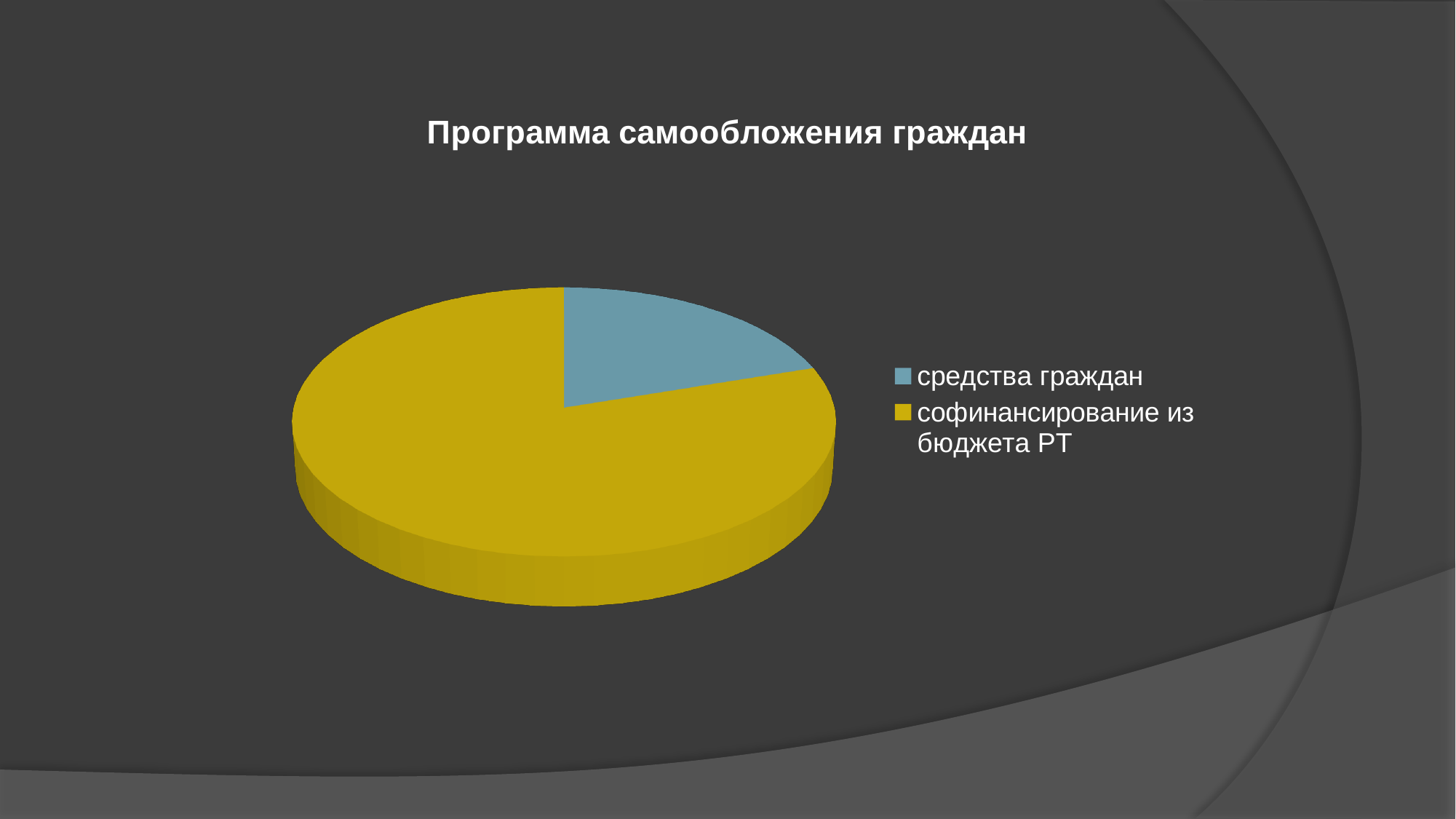
Which category has the smallest share of the pie? средства граждан What is the title of the chart? Программа самообложения граждан How many entries does the legend list? 2 Which is larger: the share for средства граждан or the share for софинансирование из бюджета РТ? софинансирование из бюджета РТ What kind of chart is shown on the slide? pie chart What colour is the slice for средства граждан? blue How many slices does the pie chart have? 2 Which category has the largest share of the pie? софинансирование из бюджета РТ